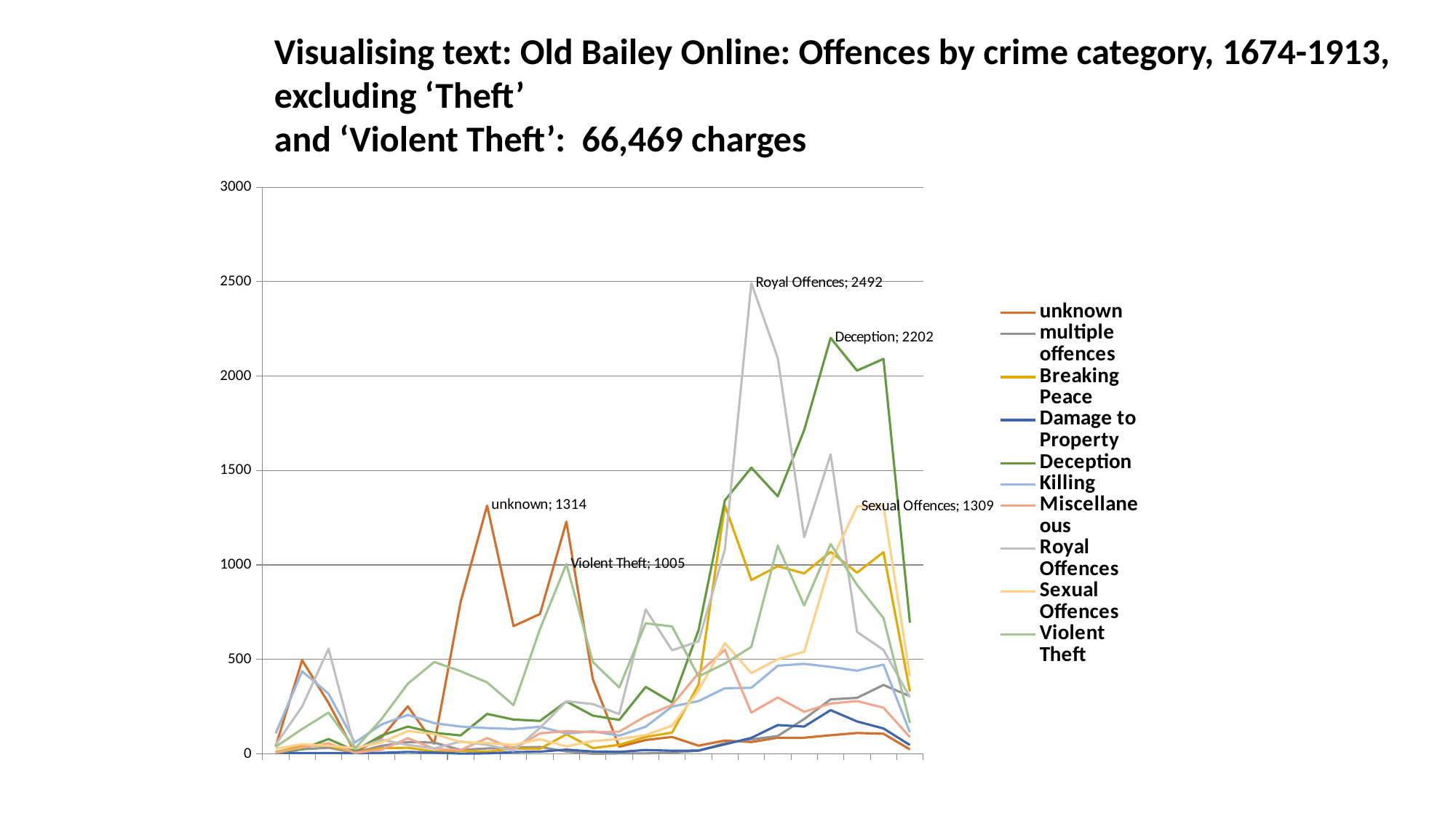
Which labelled peak is larger: Royal Offences or Deception? Royal Offences What is the labelled peak value for Violent Theft? 1005 What kind of chart is shown on the slide? line chart What is the labelled peak value for Royal Offences? 2492 According to the slide title, how many charges does the chart cover? 66,469 charges Is the highest value reached by the Damage to Property line greater or less than 500? less What is the difference between the labelled peak of Royal Offences (2492) and the labelled peak of Deception (2202)? 290 How many series does the legend list? 10 What is the labelled peak value for Sexual Offences? 1309 What is the labelled peak value for Deception? 2202 Which series reaches the highest labelled peak on the chart? Royal Offences What is the labelled peak value for the 'unknown' series? 1314